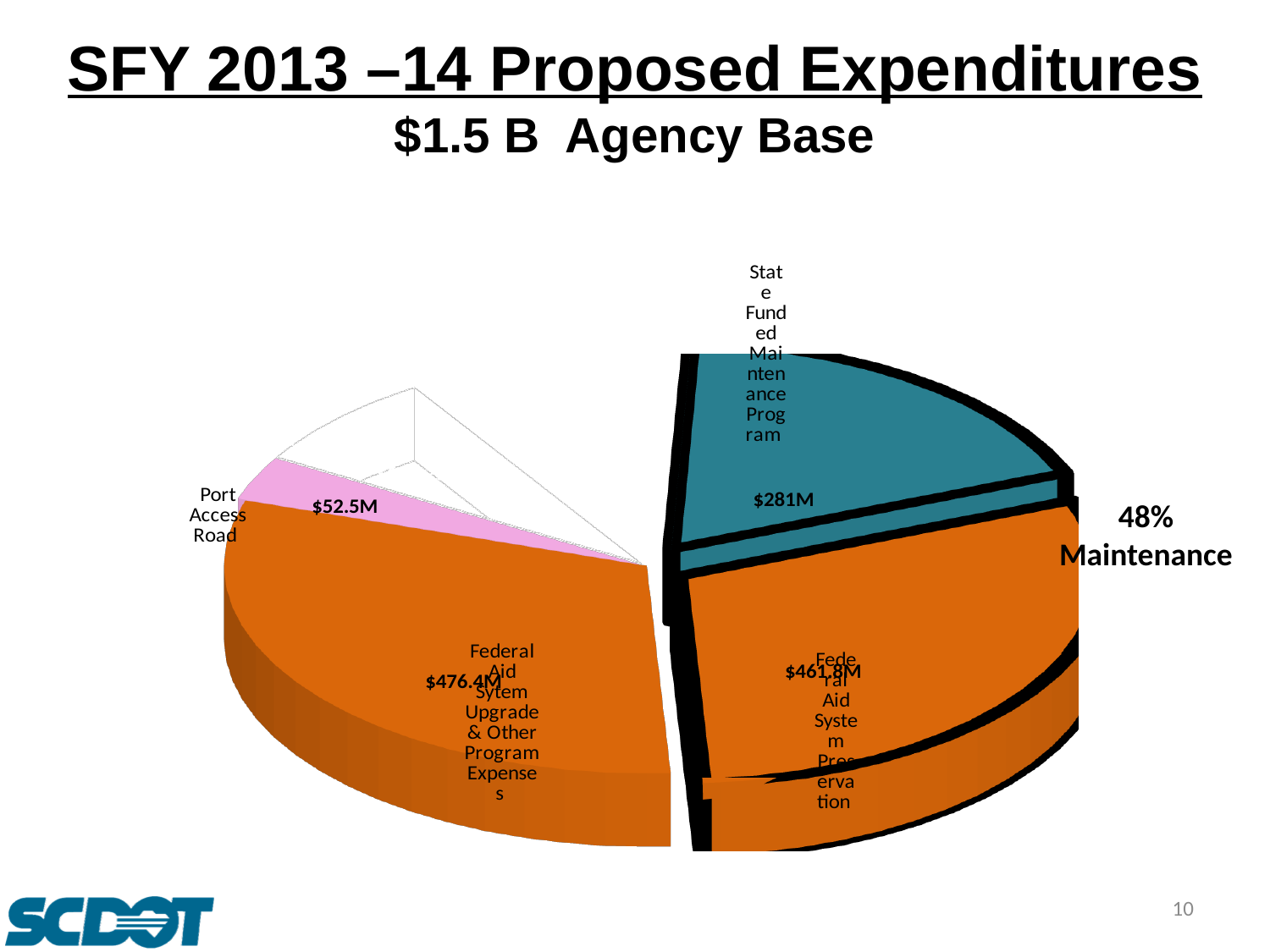
Which labeled slice has the largest value? Federal Aid System Upgrade & Other Program Expenses Which is larger, State Funded Maintenance Program or Port Access Road? State Funded Maintenance Program What is the value of the Port Access Road slice? $52.5M What is the difference between the State Funded Maintenance Program slice and the Port Access Road slice? $228.5M What is the difference between the Federal Aid System Upgrade & Other Program Expenses slice and the Federal Aid System Preservation slice? $14.6M What is the value of the Federal Aid System Upgrade & Other Program Expenses slice? $476.4M What is the value of the Federal Aid System Preservation slice? $461.8M What is the value of the State Funded Maintenance Program slice? $281M What kind of chart is shown on the slide? pie chart Which is larger, Federal Aid System Upgrade & Other Program Expenses or Federal Aid System Preservation? Federal Aid System Upgrade & Other Program Expenses What is the title of the slide containing the chart? SFY 2013 –14 Proposed Expenditures What percentage is annotated next to the chart for Maintenance? 48%